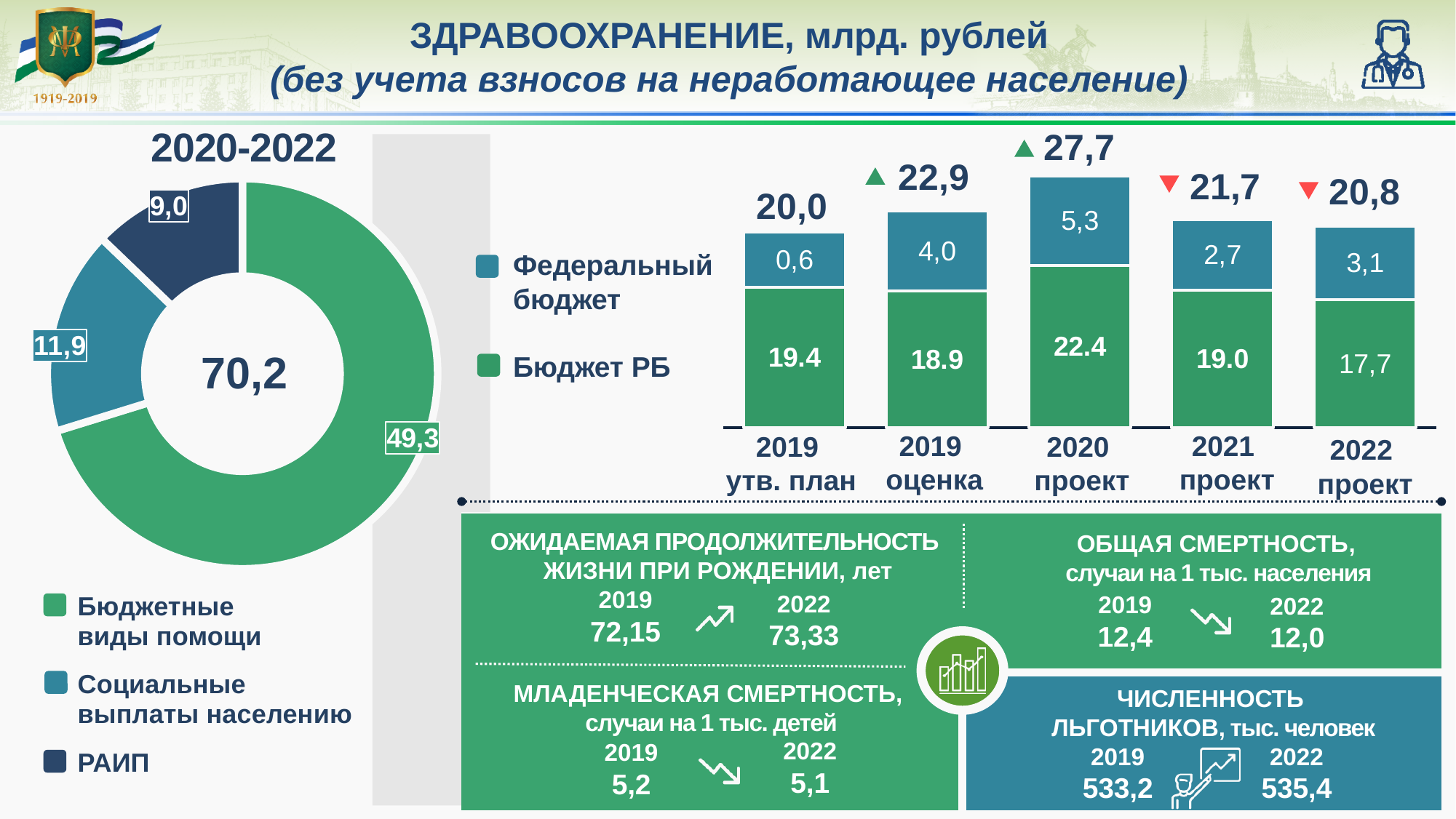
In the donut chart titled 2020-2022, which segment is the largest? Бюджетные виды помощи In the stacked bar chart, what is the value for Бюджет РБ in 2020 проект? 22.4 In the stacked bar chart, what is the total shown above the bar for 2021 проект? 21,7 In the stacked bar chart, what is the value for Федеральный бюджет in 2019 утв. план? 0,6 In the stacked bar chart, which is larger: Бюджет РБ in 2019 оценка or in 2021 проект? 2021 проект How many series does the legend of the stacked bar chart list? 2 In the stacked bar chart, what is the difference between the Федеральный бюджет values for 2020 проект and 2022 проект? 2,2 What number is shown in the centre of the donut chart titled 2020-2022? 70,2 How many categories does the stacked bar chart show? 5 In the stacked bar chart, which category has the lowest Федеральный бюджет value? 2019 утв. план In the stacked bar chart, which category has the highest total? 2020 проект In the donut chart titled 2020-2022, what is the value for Социальные выплаты населению? 11,9